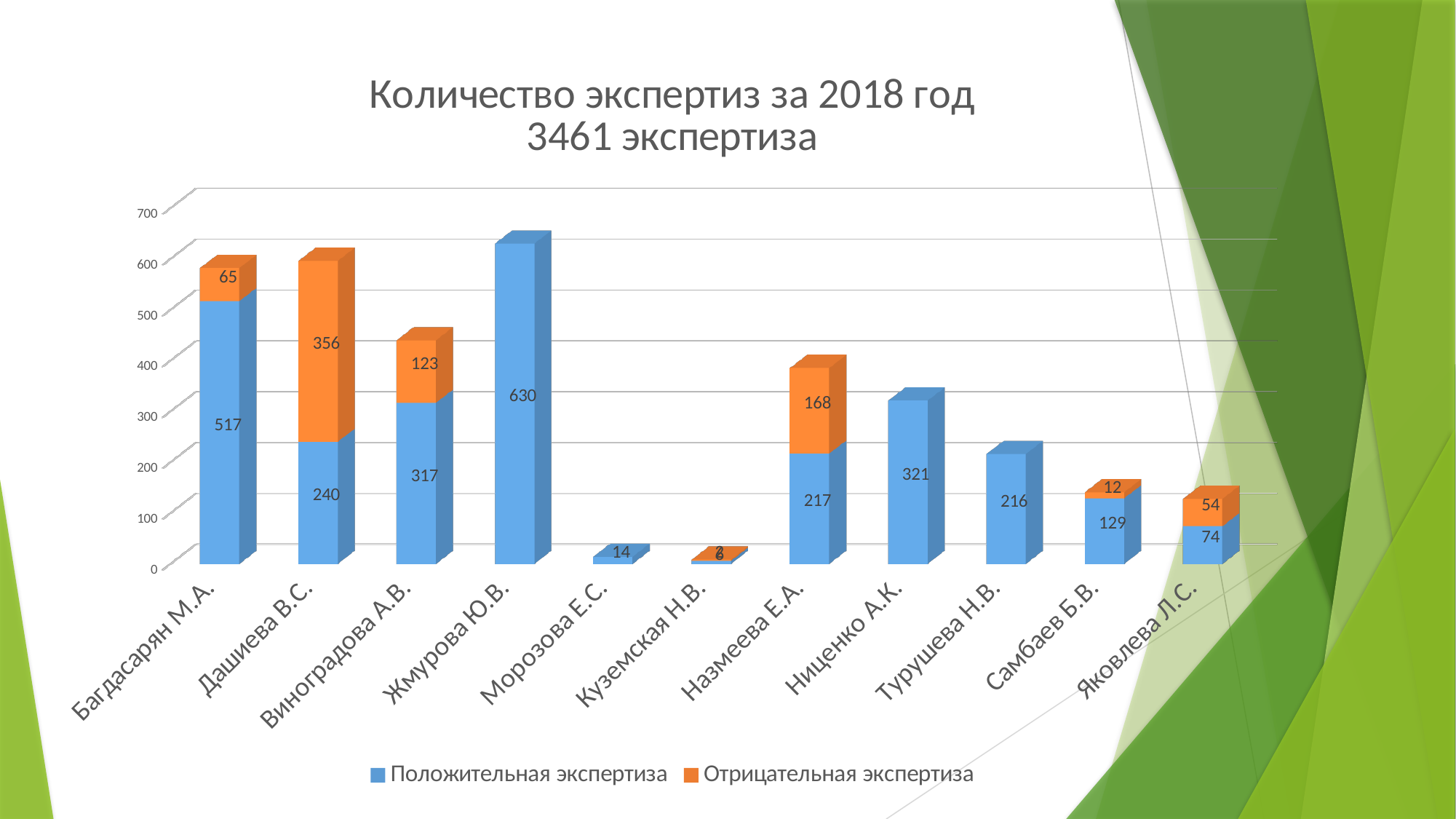
What is the total of the stacked bar for Виноградова А.В.? 440 What is the value of Положительная экспертиза for Самбаев Б.В.? 129 What is the total of the stacked bar for Яковлева Л.С.? 128 Which is larger, Положительная экспертиза for Назмеева Е.А. or for Турушева Н.В.? Назмеева Е.А. What kind of chart is shown on the slide? Stacked bar chart What is the value of Отрицательная экспертиза for Дашиева В.С.? 356 What is the difference between Положительная экспертиза for Багдасарян М.А. and Дашиева В.С.? 277 Which category has the highest value for Отрицательная экспертиза? Дашиева В.С. How many categories are shown on the x axis? 11 What is the value of Положительная экспертиза for Жмурова Ю.В.? 630 How many series does the legend list? 2 Which category has the highest value for Положительная экспертиза? Жмурова Ю.В.